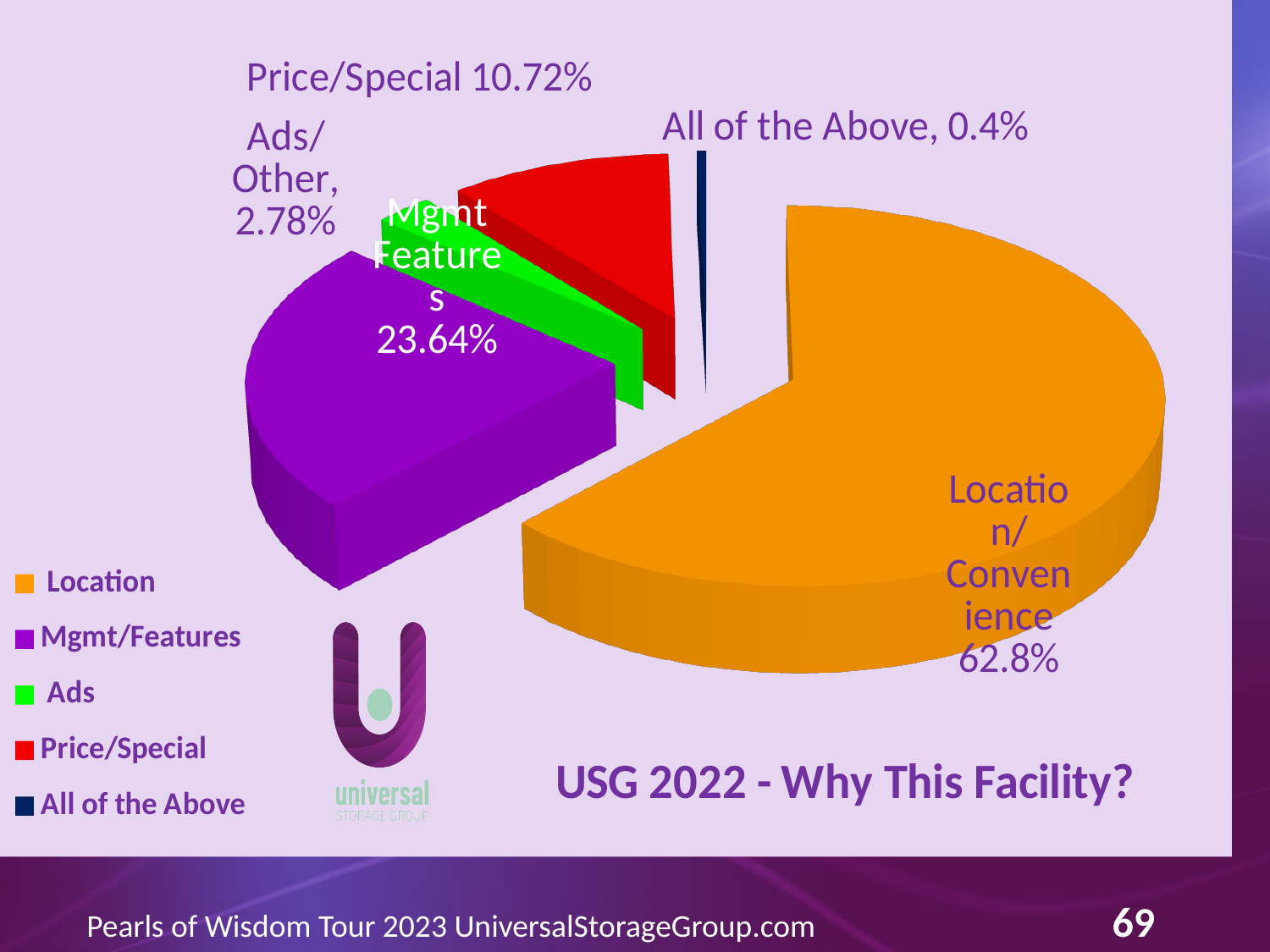
What percentage is shown for Price/Special? 10.72% What is the difference in percentage points between Location/Convenience and Mgmt/Features? 39.16 What percentage is shown for Ads/Other? 2.78% What kind of chart is shown on the slide? Pie chart How many slices does the pie chart have? 5 Which category has the smallest slice of the pie? All of the Above Which category has the largest slice of the pie? Location/Convenience What share of the pie does Location/Convenience hold? 62.8% What percentage is shown for All of the Above? 0.4% What is the title of the chart? USG 2022 - Why This Facility? Which is larger, Price/Special or Ads/Other? Price/Special What percentage is shown for Mgmt/Features? 23.64%